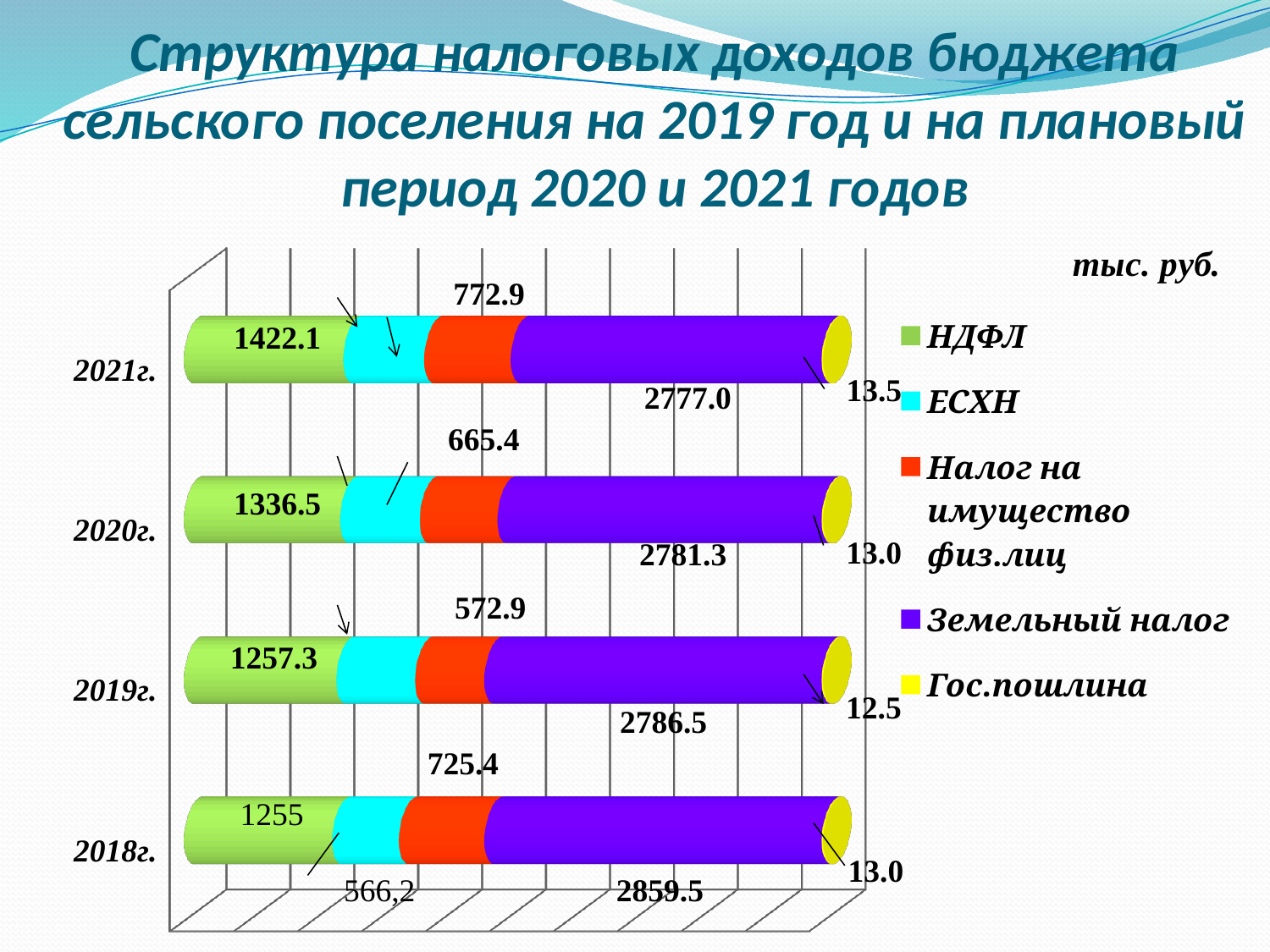
What kind of chart is shown on the slide? Stacked bar chart In which year is НДФЛ the highest? 2021г. What is the value of НДФЛ for 2021г.? 1422.1 Which is larger: Земельный налог in 2018г. or in 2021г.? 2018г. How many series does the legend list? 5 How many years (categories) are plotted on the chart? 4 In which year is Земельный налог the lowest? 2021г. What is the value of Гос.пошлина for 2019г.? 12.5 In what units are the values on the chart given? тыс. руб. What is the value of Гос.пошлина for 2021г.? 13.5 What is the difference between НДФЛ in 2021г. and in 2020г.? 85.6 What is the value of Земельный налог for 2018г.? 2859.5